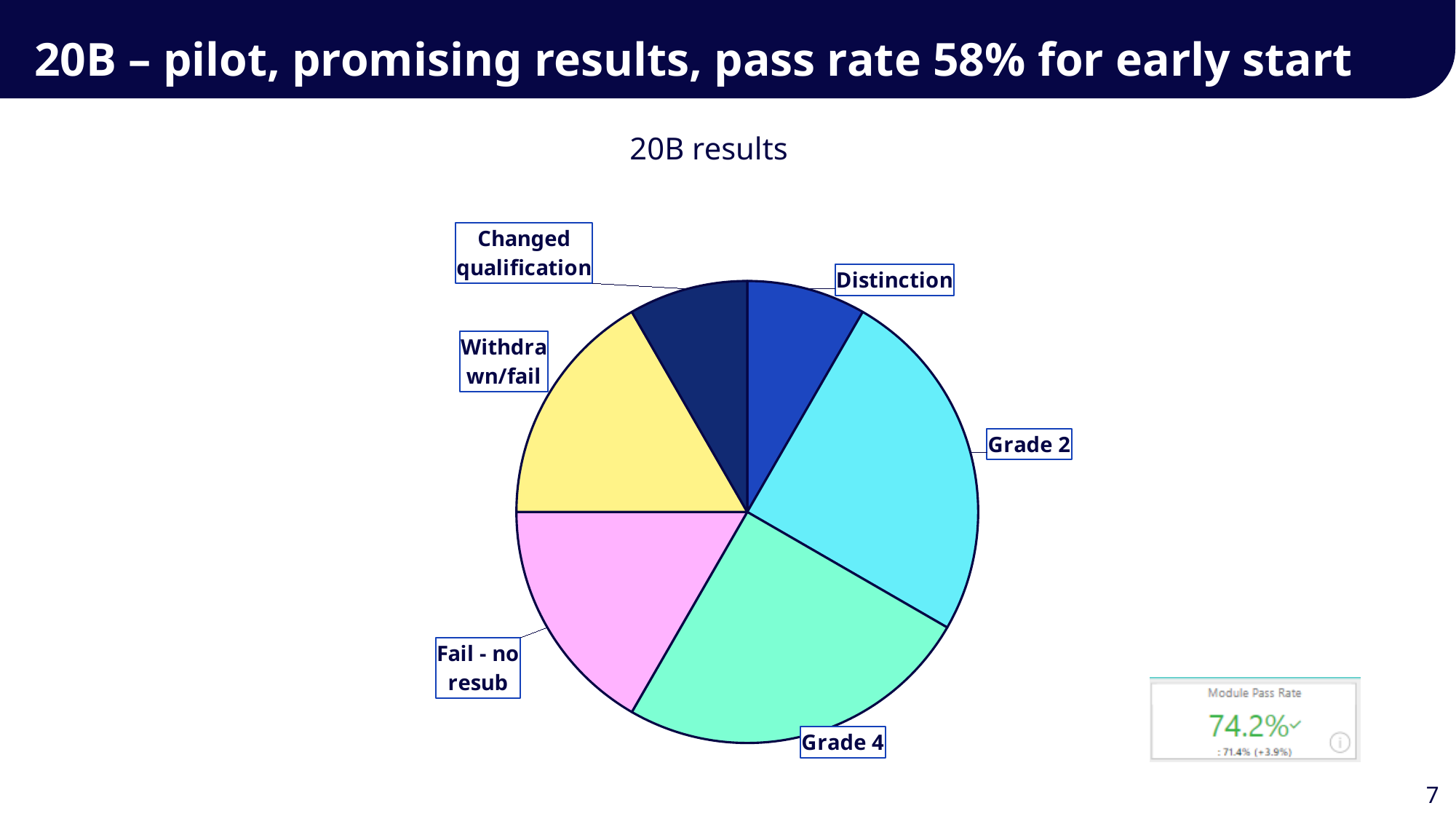
What is the title of the pie chart? 20B results What colour is the Grade 4 slice of the pie chart? Light green What kind of chart is shown on the slide? Pie chart How many slices does the pie chart have? 6 Which slice is larger, Withdrawn/fail or Distinction? Withdrawn/fail Which slice is larger, Grade 2 or Changed qualification? Grade 2 Which slice is larger, Grade 4 or Fail - no resub? Grade 4